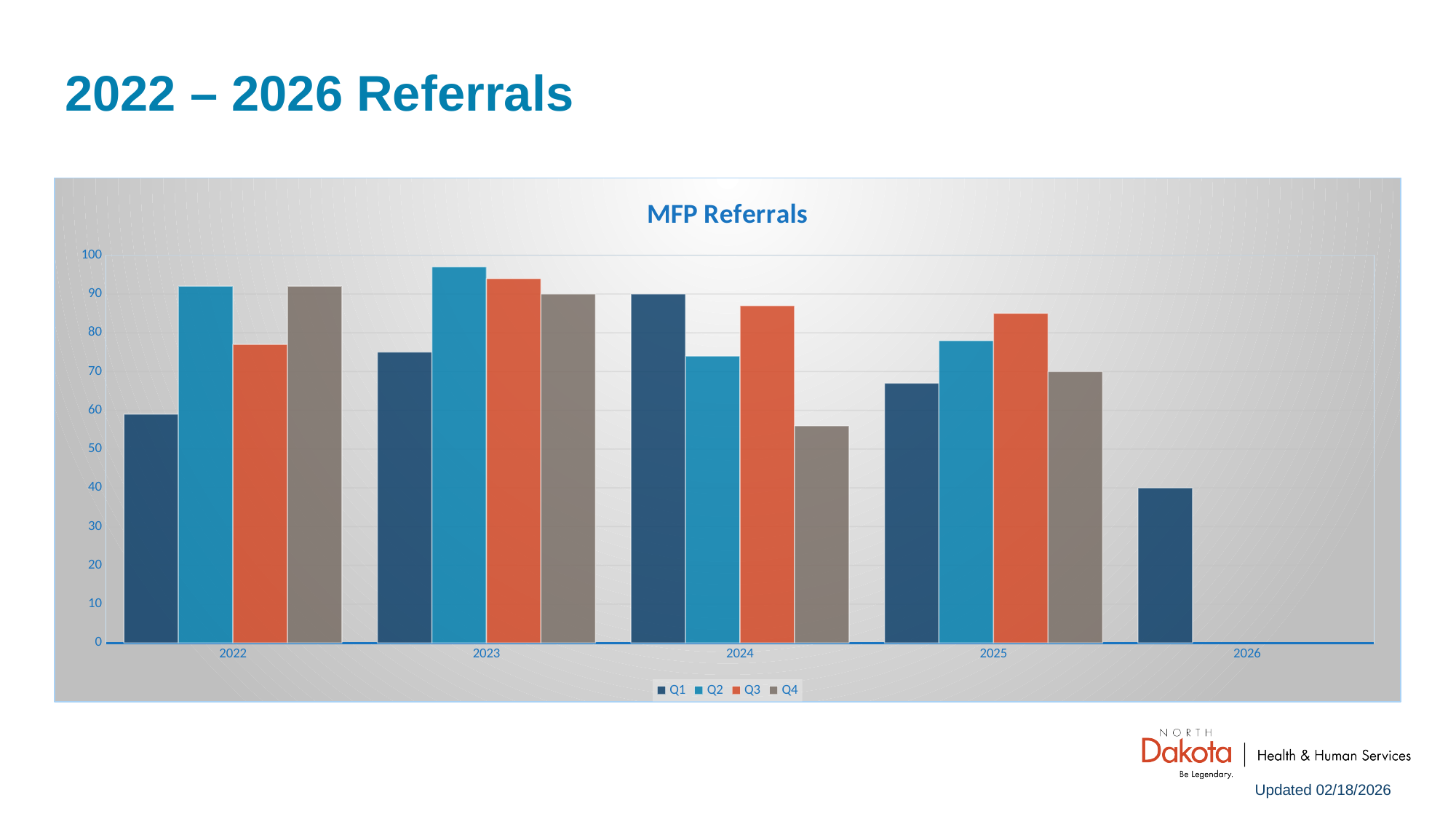
What is the title of the chart? MFP Referrals Does the Q1 value rise or fall from 2022 to 2024? rise Which year has the highest Q1 bar? 2024 Which year has the lowest Q1 bar? 2026 How many years are shown on the x axis of the MFP Referrals chart? 5 Which year has the lowest Q4 bar? 2024 How many series does the legend of the MFP Referrals chart list? 4 What kind of chart is shown on the slide? bar chart Is the Q1 value for 2026 greater or less than 50? less Is the Q4 value for 2024 greater or less than 70? less Which is larger, the Q1 value for 2022 or the Q1 value for 2023? 2023 Is the Q2 value for 2023 greater or less than 90? greater